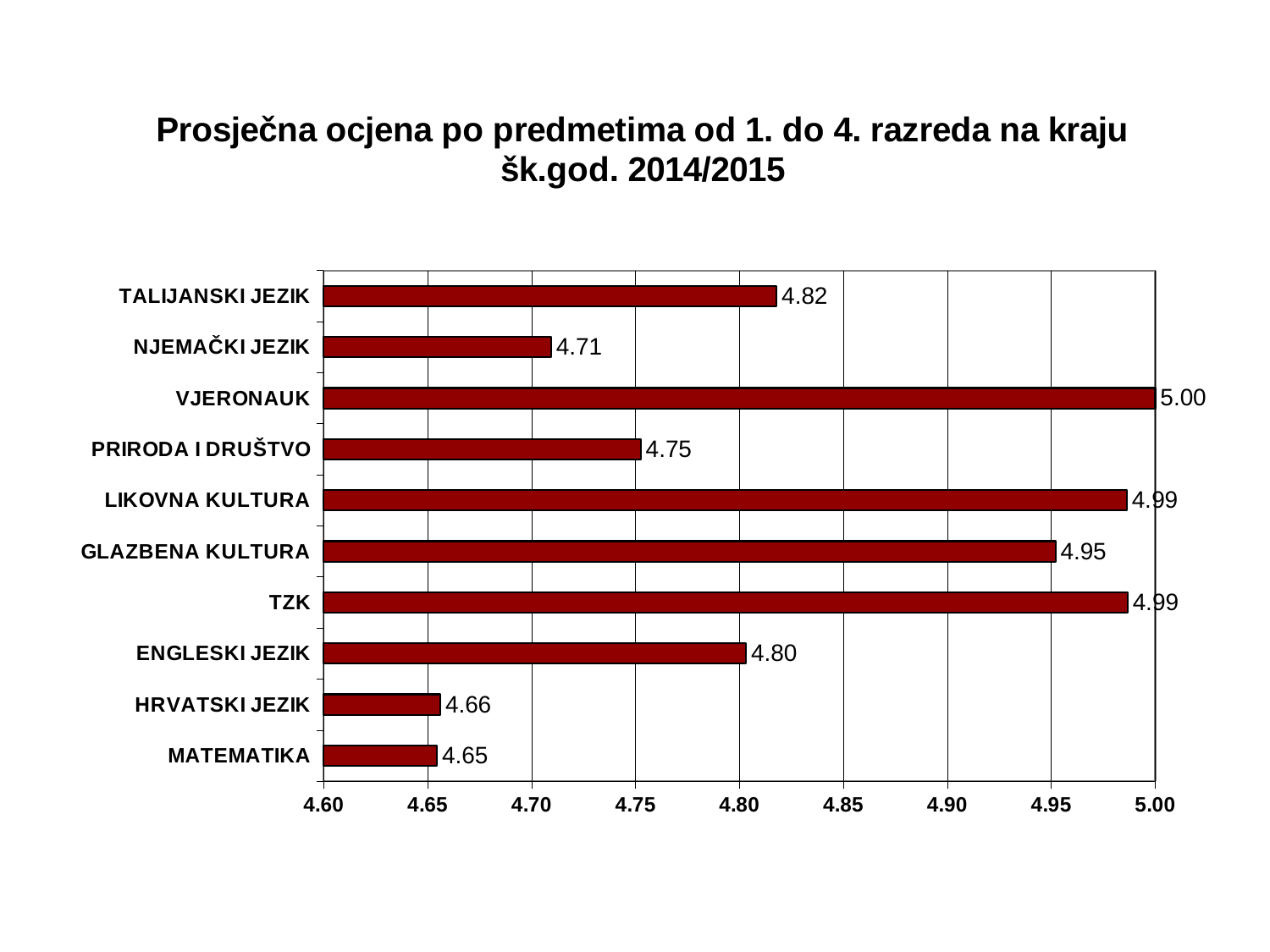
How many subjects are shown in the chart? 10 Which has a higher average grade, GLAZBENA KULTURA or PRIRODA I DRUŠTVO? GLAZBENA KULTURA What is the average grade for NJEMAČKI JEZIK? 4.71 What kind of chart is shown on the slide? bar chart Which subject has the lowest average grade? MATEMATIKA Is the value for TALIJANSKI JEZIK greater or less than 4.80? greater Which subject has the highest average grade? VJERONAUK What is the average grade for VJERONAUK? 5.00 What is the average grade for MATEMATIKA? 4.65 What is the average grade for ENGLESKI JEZIK? 4.80 What is the difference between the average grades for TALIJANSKI JEZIK and HRVATSKI JEZIK? 0.16 What is the title of the chart? Prosječna ocjena po predmetima od 1. do 4. razreda na kraju šk.god. 2014/2015